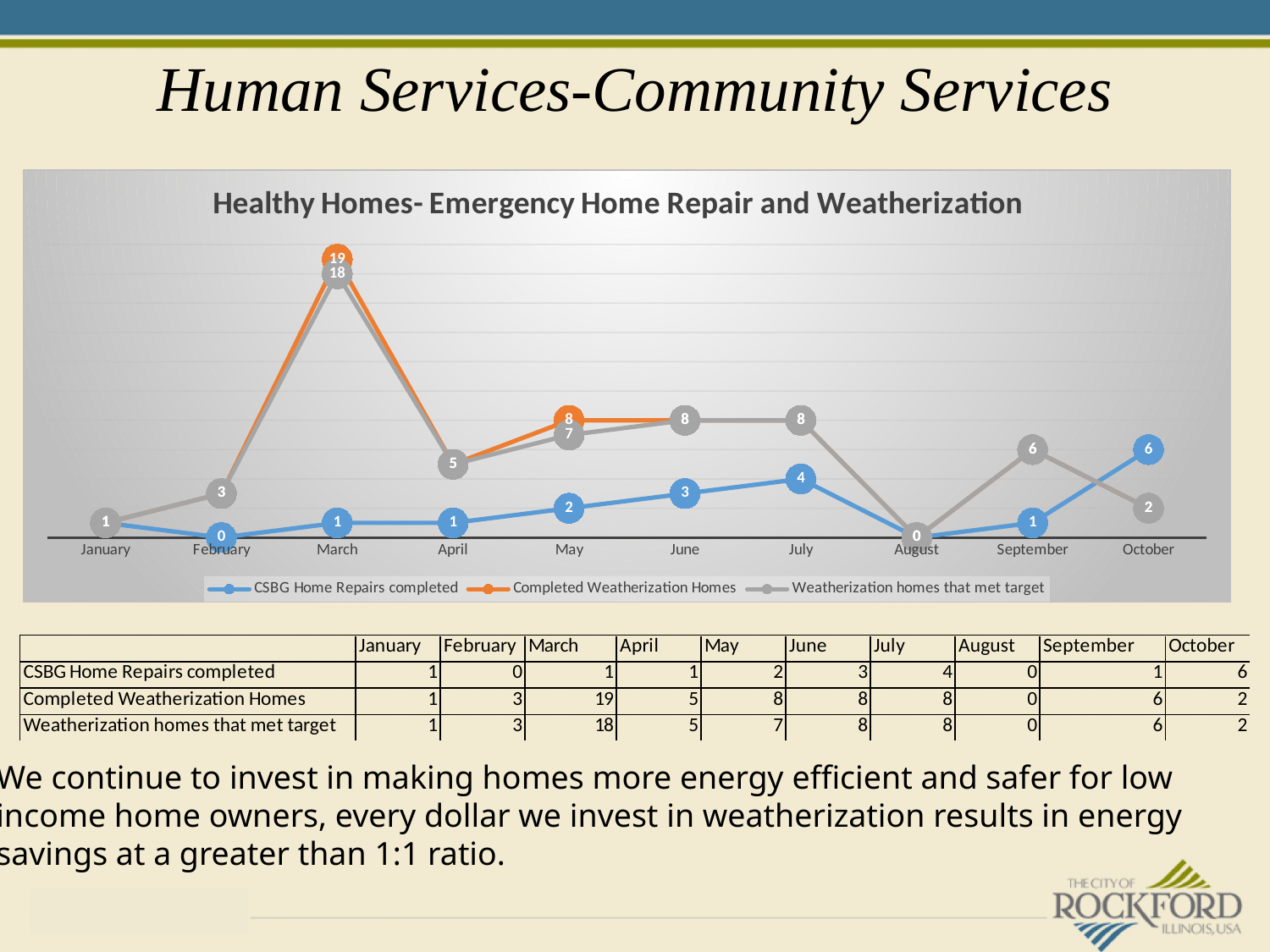
What is the value of Completed Weatherization Homes in March? 19 Does CSBG Home Repairs completed rise or fall from April to July? rise What kind of chart is shown on the slide? line chart What is the chart's title? Healthy Homes- Emergency Home Repair and Weatherization In which month is CSBG Home Repairs completed highest? October What is the difference between Completed Weatherization Homes and Weatherization homes that met target in March? 1 What is the value of Weatherization homes that met target in May? 7 In which month is Completed Weatherization Homes highest? March How many series does the legend list? 3 Which is larger in July: CSBG Home Repairs completed or Completed Weatherization Homes? Completed Weatherization Homes What is the value of CSBG Home Repairs completed in October? 6 How many months are plotted along the x axis? 10